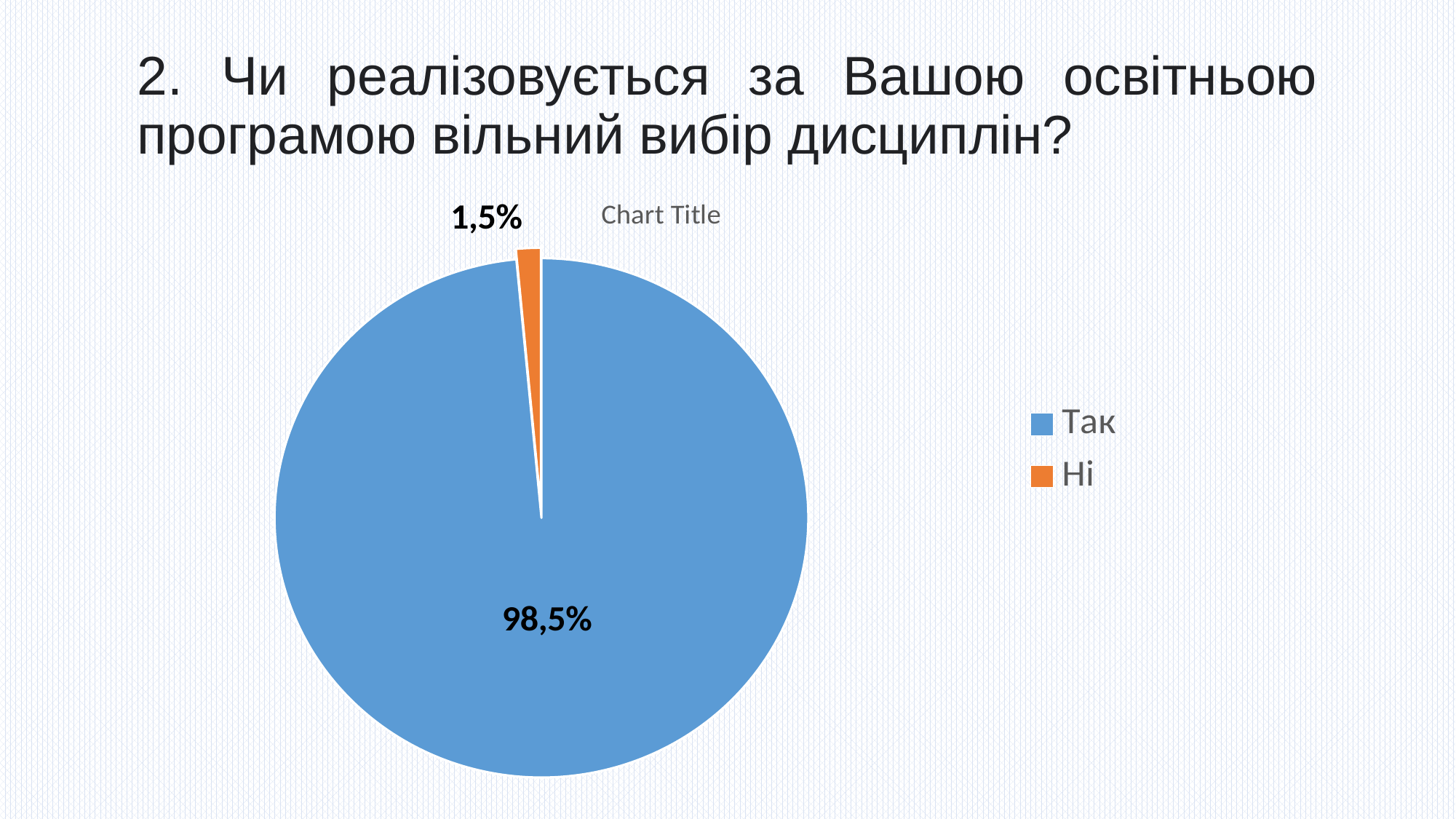
Which slice is larger, "Так" or "Ні"? Так What kind of chart is shown on the slide? pie chart What is the difference in percentage points between the "Так" and "Ні" slices? 97 percentage points How many categories does the pie chart show? 2 What share of the pie does "Ні" have? 1,5% What is the title printed above the pie chart? Chart Title What share of the pie does "Так" have? 98,5% Which category has the largest slice of the pie? Так What colour is the "Ні" slice? orange Which category has the smallest slice of the pie? Ні How many entries does the legend list? 2